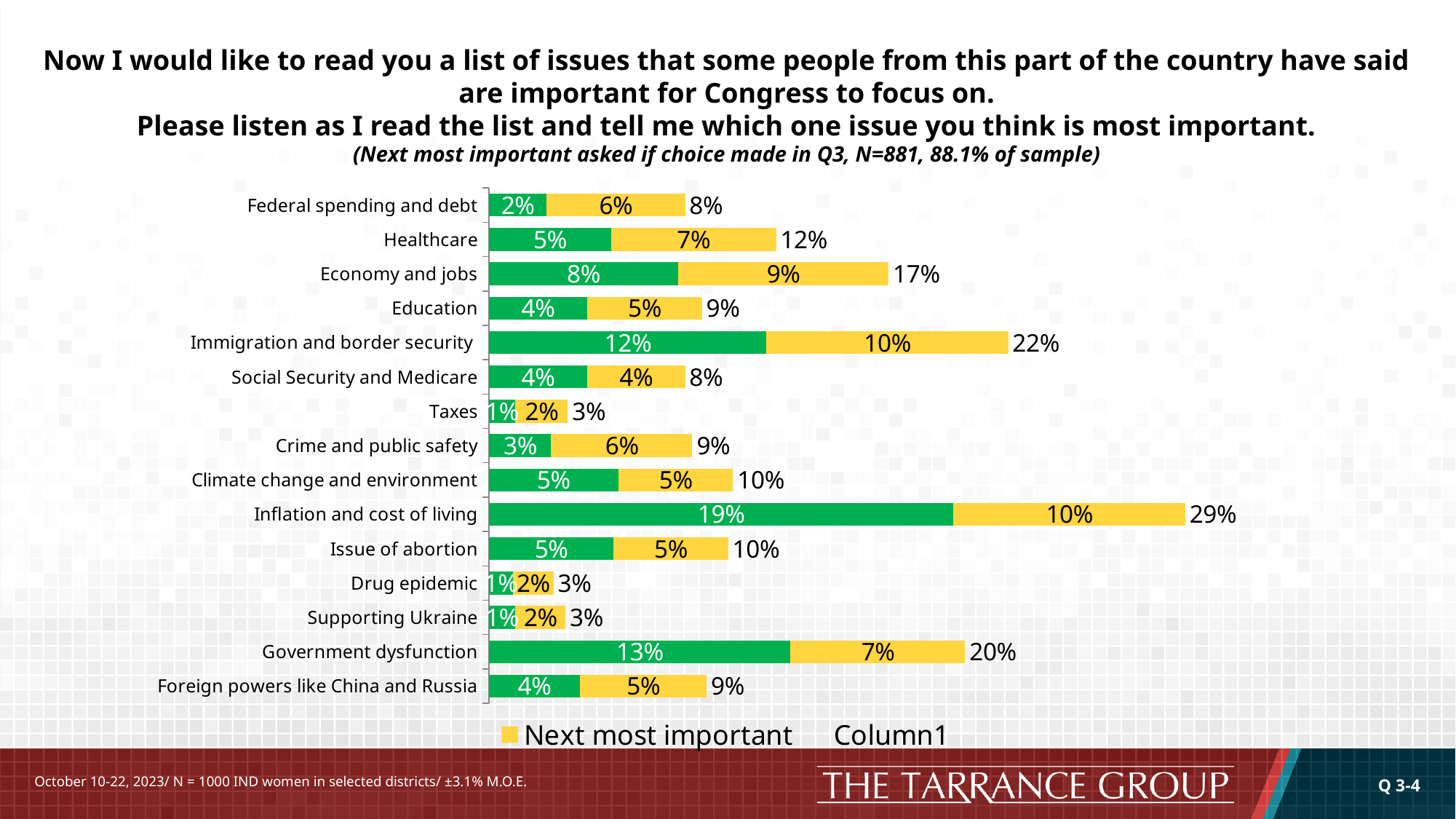
What kind of chart is shown on the slide? Stacked bar chart Which category has the largest green segment? Inflation and cost of living What is the 'Next most important' value for Immigration and border security? 10% What is the value of the green segment for Government dysfunction? 13% What colour represents the 'Next most important' series in the legend? Yellow What is the total value shown for Taxes? 3% What is the difference between the total for Immigration and border security and the total for Government dysfunction? 2% Which has a larger total, Economy and jobs or Healthcare? Economy and jobs Which category has the highest total value? Inflation and cost of living How many categories are shown on the chart? 15 What is the total value shown for Inflation and cost of living? 29% What is the 'Next most important' value for Economy and jobs? 9%